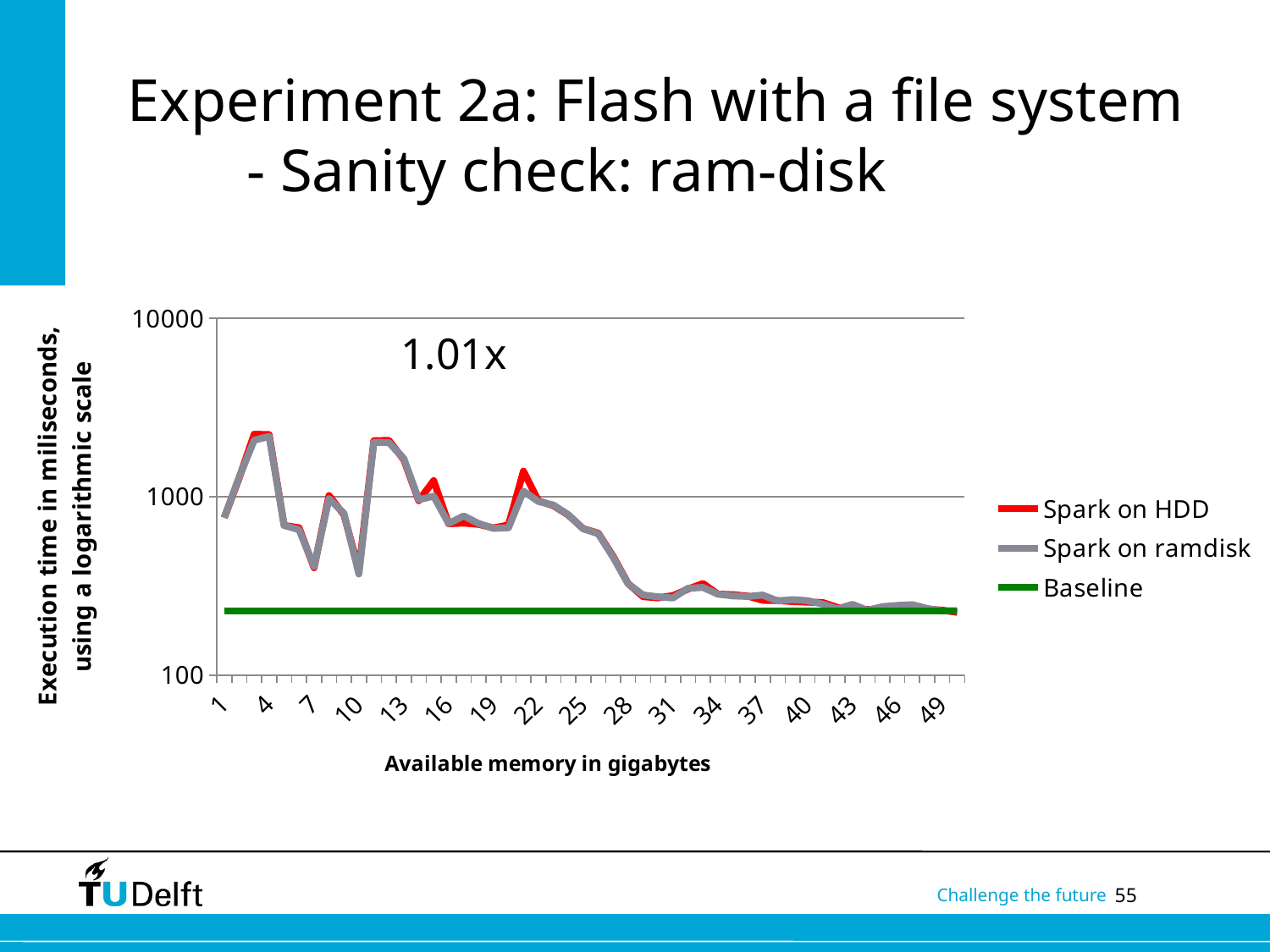
What is the highest value shown on the y axis? 10000 Is the value for Spark on HDD at 13 gigabytes greater or less than 1000? greater What kind of chart is shown on the slide? line chart Is the value for Spark on HDD at 49 gigabytes greater or less than 1000? less Is the value for Spark on ramdisk at 4 gigabytes greater or less than 1000? greater How many series does the legend list? 3 Which is larger at 4 gigabytes: Spark on ramdisk or Baseline? Spark on ramdisk Do the Spark on HDD values generally rise or fall as available memory increases? fall What is the title of the x axis? Available memory in gigabytes Which series is drawn in green? Baseline